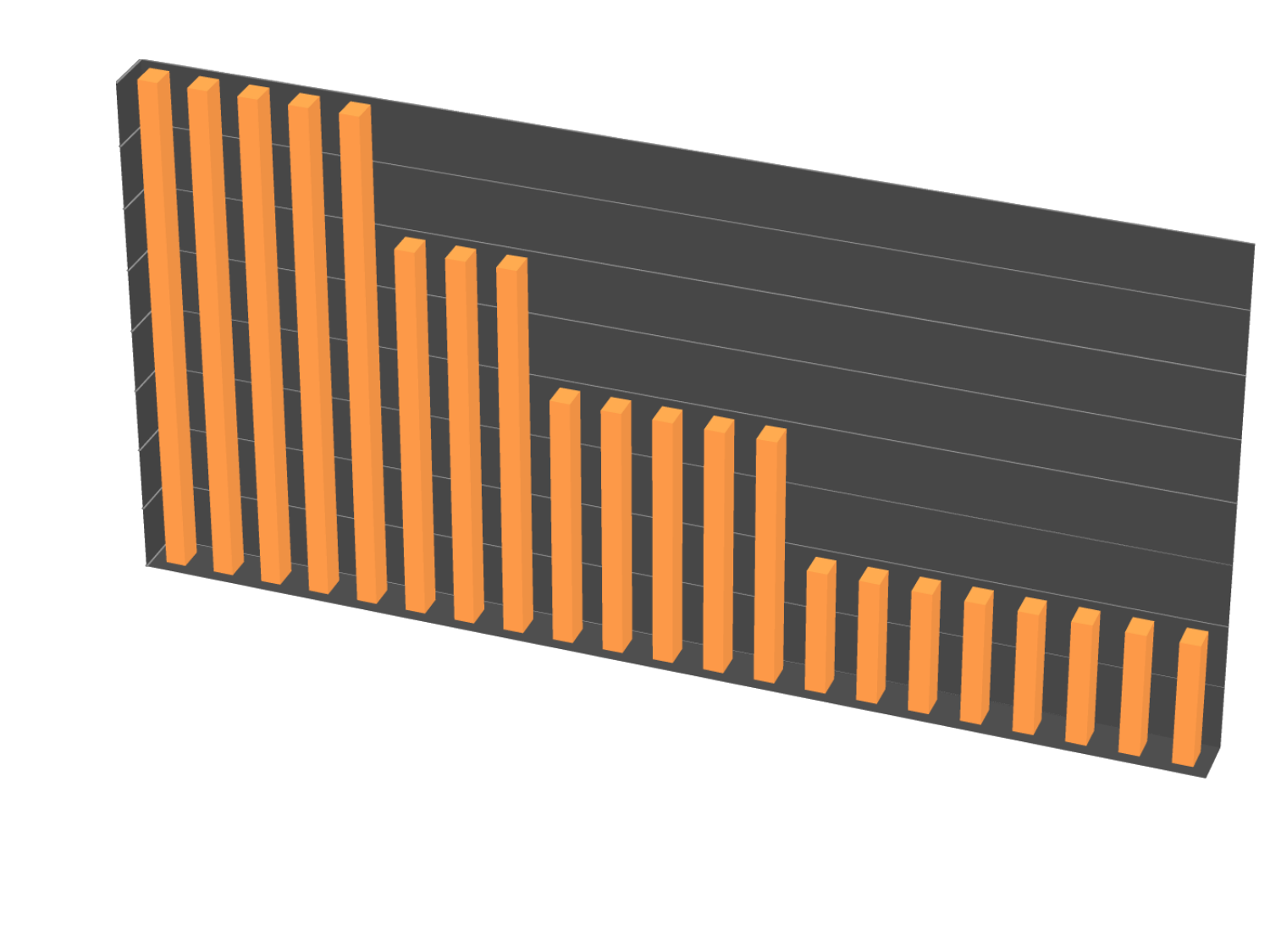
How many bars are plotted in the chart? 21 What kind of chart is shown on the slide? bar chart What colour are the bars in the chart? orange Which bar is taller, the leftmost bar or the rightmost bar? the leftmost bar Does the chart display a title? No Is the tallest bar at the left end or the right end of the chart? left end Is the shortest bar at the left end or the right end of the chart? right end Do the bar values rise or fall from left to right along the x axis? fall